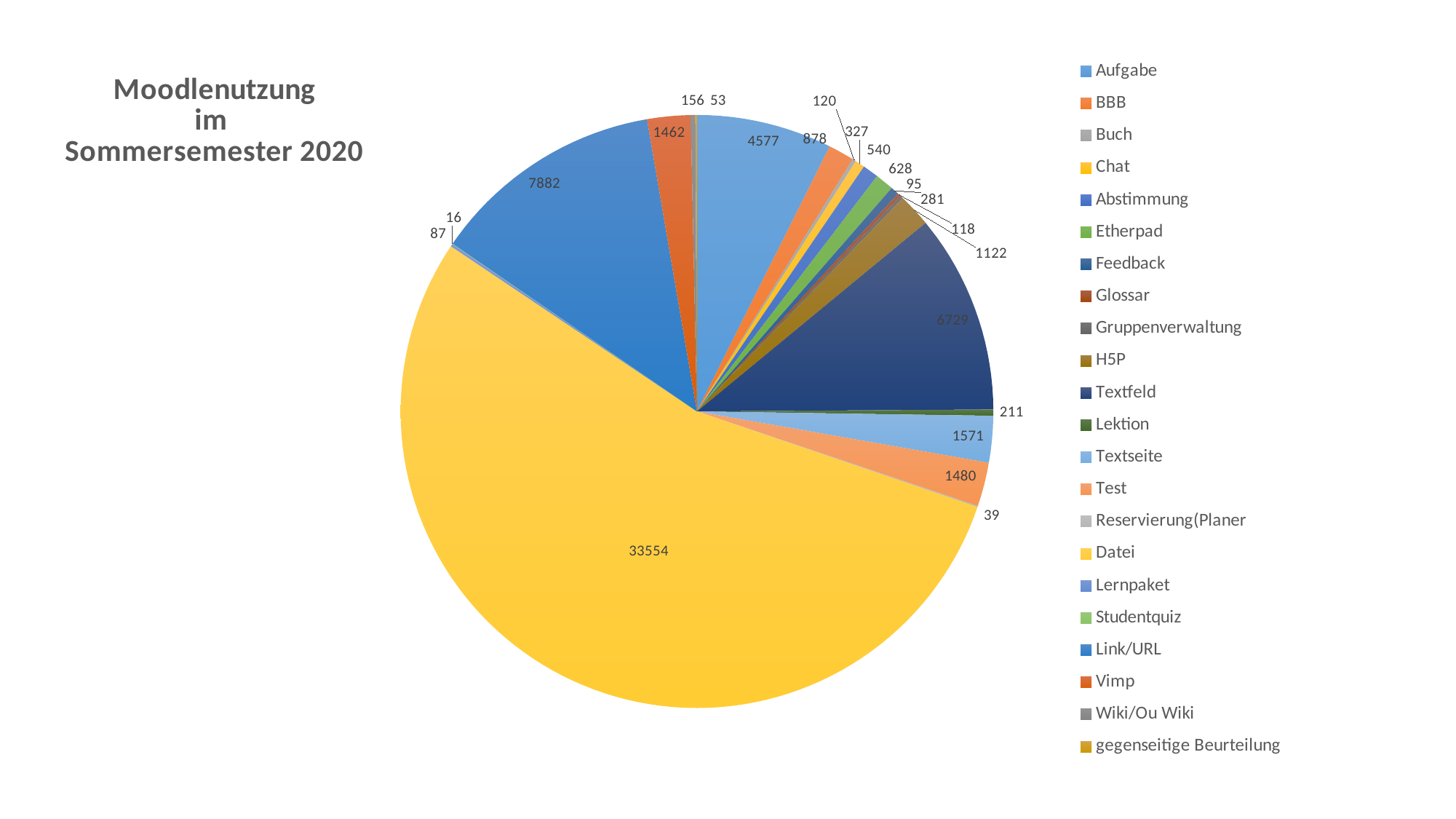
What value is shown for the Vimp slice? 1462 What is the difference between the Link/URL value and the Textfeld value? 1153 Which is larger, the value for Textseite or the value for Test? Textseite What value is shown for the Datei slice? 33554 Which category has the smallest value in the pie chart? Studentquiz What value is shown for the Textfeld slice? 6729 What value is shown for the Aufgabe slice? 4577 What value is shown for the Link/URL slice? 7882 What is the title of the chart? Moodlenutzung im Sommersemester 2020 What kind of chart is shown on the slide? Pie chart How many categories does the legend list? 22 Which category has the largest slice of the pie? Datei